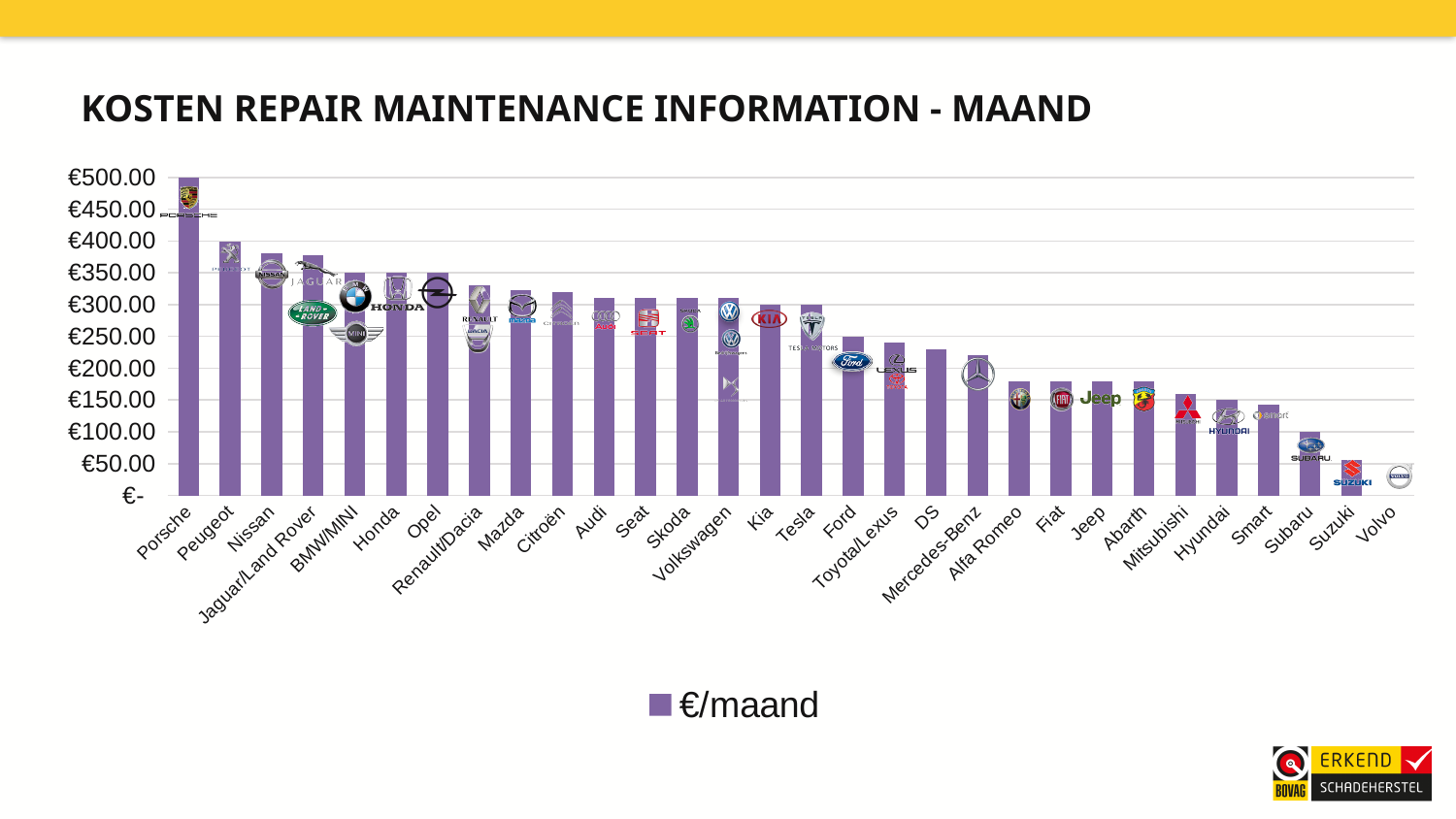
Which car brand has the highest monthly repair maintenance information cost? Porsche Is the value for Porsche greater or less than €450.00? greater How many car brands are shown on the x axis? 30 What kind of chart is shown on the slide? bar chart Is the value for Peugeot greater or less than €350.00? greater What is the legend entry for the series shown in the chart? €/maand Is the value for Volvo greater or less than €50.00? less Do the values generally rise or fall from left to right along the x axis? fall Which has a higher value, Kia or Subaru? Kia